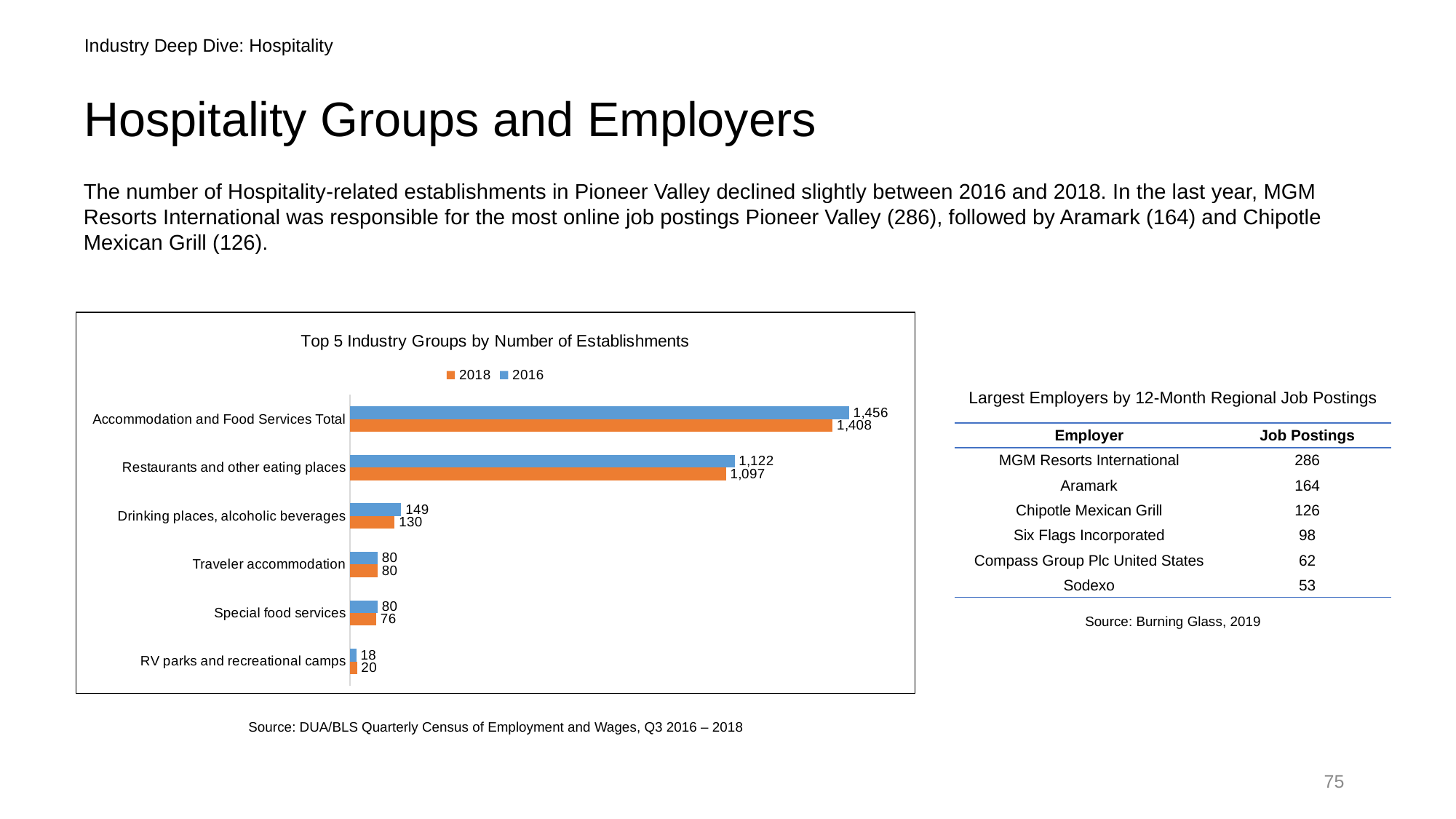
In the chart 'Top 5 Industry Groups by Number of Establishments', what is the difference between the 2016 and 2018 values for Drinking places, alcoholic beverages? 19 In the chart 'Top 5 Industry Groups by Number of Establishments', what is the 2016 value for RV parks and recreational camps? 18 In the chart 'Top 5 Industry Groups by Number of Establishments', what is the 2018 value for Restaurants and other eating places? 1,097 How many series does the legend of the chart 'Top 5 Industry Groups by Number of Establishments' list? 2 How many industry groups are shown in the chart 'Top 5 Industry Groups by Number of Establishments'? 6 In the chart 'Top 5 Industry Groups by Number of Establishments', which industry group has the lowest 2016 value? RV parks and recreational camps In the chart 'Top 5 Industry Groups by Number of Establishments', what is the 2016 value for Accommodation and Food Services Total? 1,456 In the chart 'Top 5 Industry Groups by Number of Establishments', for RV parks and recreational camps, which year has the larger value, 2016 or 2018? 2018 In the chart 'Top 5 Industry Groups by Number of Establishments', what is the 2018 value for Drinking places, alcoholic beverages? 130 What type of chart is 'Top 5 Industry Groups by Number of Establishments'? Bar chart In the chart 'Top 5 Industry Groups by Number of Establishments', which industry group has the highest 2018 value? Accommodation and Food Services Total In the chart 'Top 5 Industry Groups by Number of Establishments', by how much did Accommodation and Food Services Total decrease from 2016 to 2018? 48